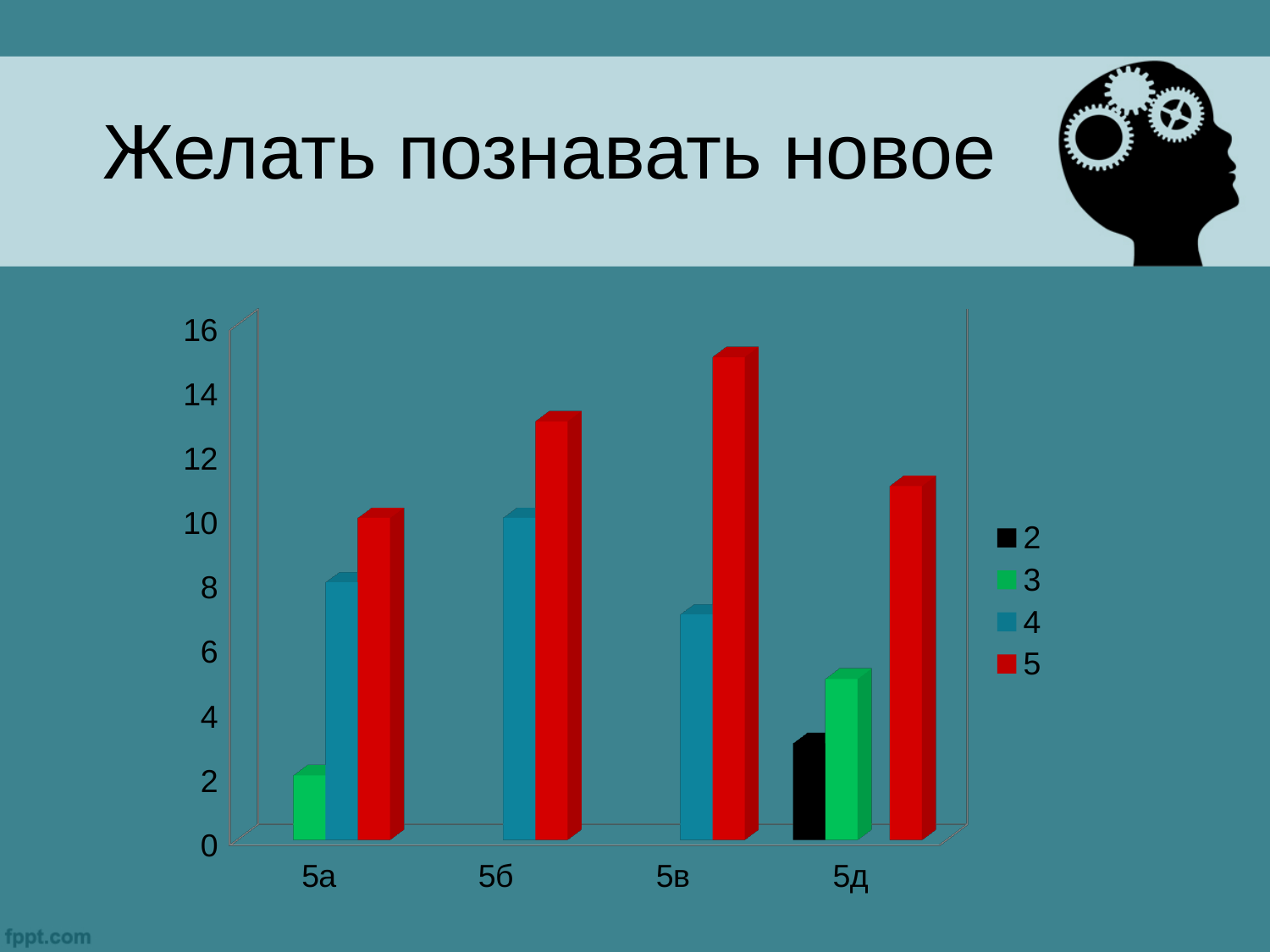
Which category has the highest bar for series 5? 5в Is the value for series 2 in category 5д greater or less than 4? less What entries are listed in the chart's legend? 2, 3, 4, 5 Is the value for series 5 in category 5в greater or less than 14? greater What kind of chart is shown on the slide? bar chart How many series does the chart's legend list? 4 Which category has the larger bar for series 4: 5б or 5в? 5б Which category has the lowest bar for series 5? 5а Is the value for series 5 in category 5б greater or less than 12? greater How many categories are shown on the x axis of the chart? 4 What is the value for series 3 in category 5а? 2 What is the value for series 4 in category 5а? 8